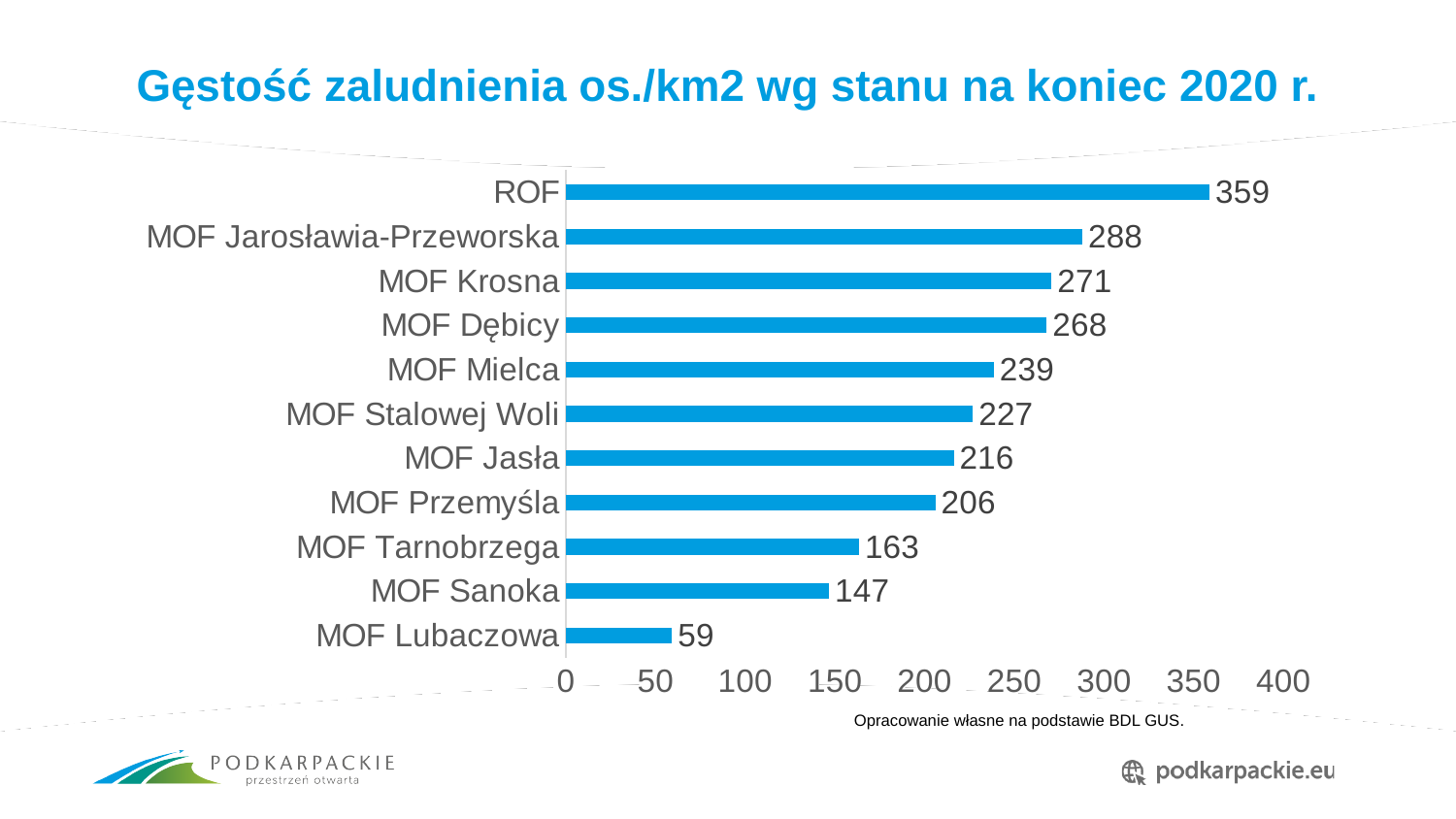
What is the title of the chart? Gęstość zaludnienia os./km2 wg stanu na koniec 2020 r. Which has a larger value, MOF Mielca or MOF Stalowej Woli? MOF Mielca Which category has the lowest population density? MOF Lubaczowa How many categories are shown in the chart? 11 What is the maximum value shown on the horizontal axis? 400 What is the population density value for MOF Krosna? 271 What is the value shown for MOF Sanoka? 147 Is the value for MOF Przemyśla greater or less than 250? less What kind of chart is shown on the slide? bar chart What is the difference between the values for MOF Tarnobrzega and MOF Lubaczowa? 104 What is the difference between the values for ROF and MOF Jarosławia-Przeworska? 71 Which category has the highest population density? ROF